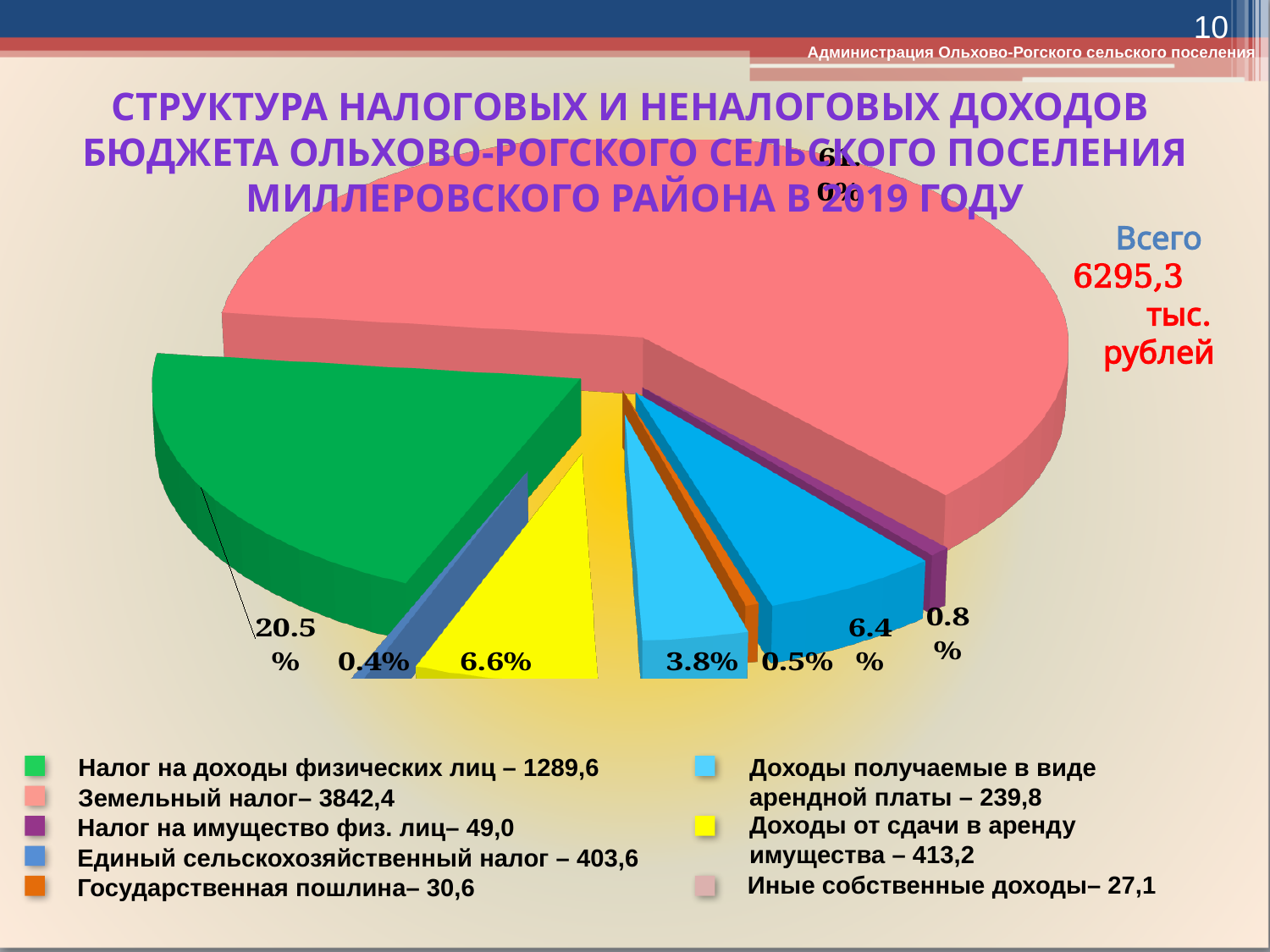
What is the value shown for Государственная пошлина? 30,6 What is the value shown for Земельный налог? 3842,4 What colour represents Земельный налог in the legend? pink What total amount (Всего) is shown next to the pie chart? 6295,3 тыс. рублей How many revenue categories does the legend list? 8 What is the difference between Налог на доходы физических лиц and Единый сельскохозяйственный налог? 886,0 What kind of chart is shown on the slide? pie chart What share of the pie does the green slice (Налог на доходы физических лиц) represent? 20.5% What is the value shown for Налог на доходы физических лиц? 1289,6 Which category has the smallest value? Иные собственные доходы Which is larger: Единый сельскохозяйственный налог or Доходы от сдачи в аренду имущества? Доходы от сдачи в аренду имущества Which category has the largest value? Земельный налог